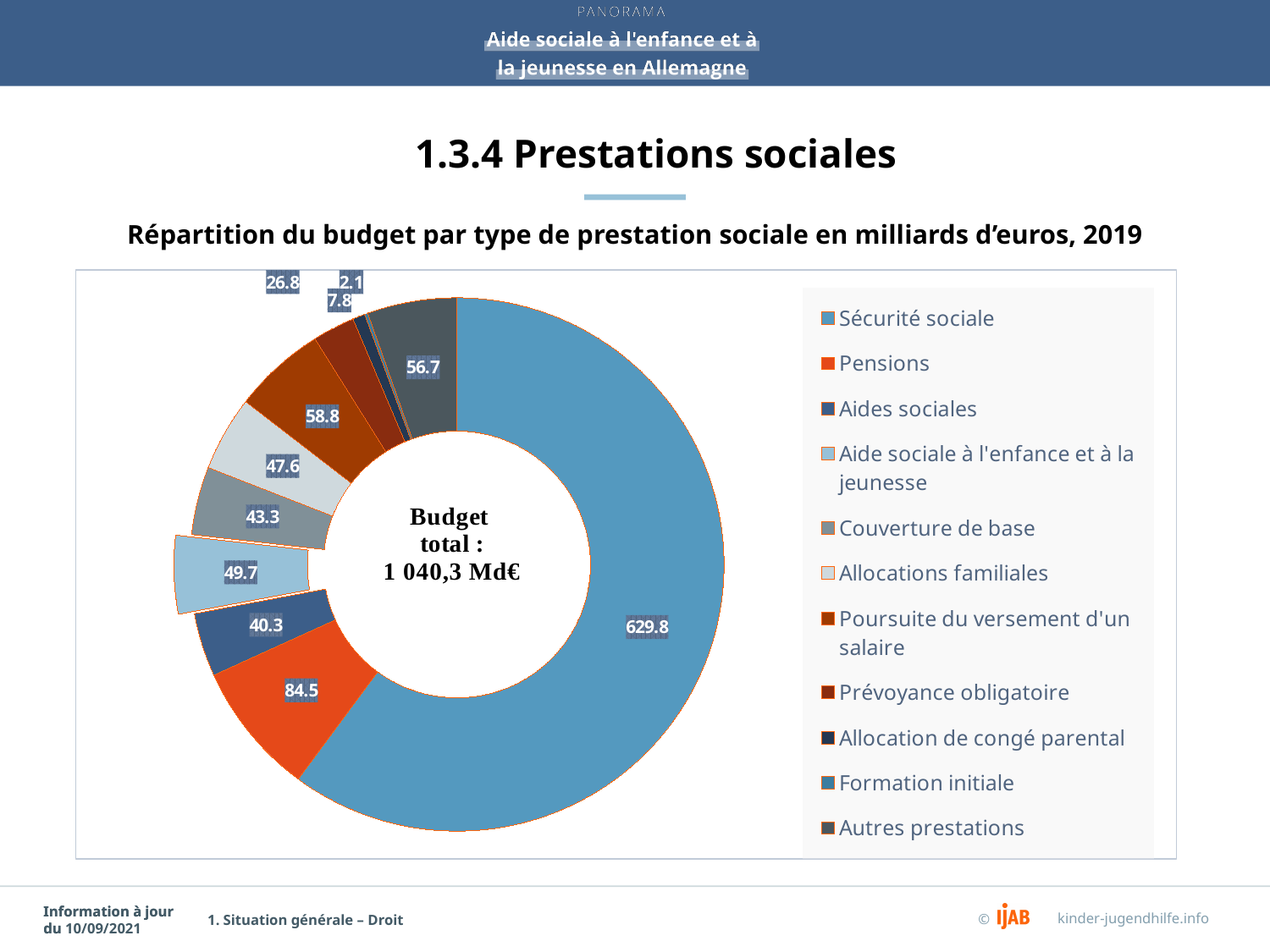
Which category has the largest share of the budget? Sécurité sociale What is the difference between the values for Pensions and Aide sociale à l'enfance et à la jeunesse? 34.8 What is the value for Pensions? 84.5 What is the value for Aide sociale à l'enfance et à la jeunesse? 49.7 Which is larger, Aides sociales or Couverture de base? Couverture de base What is the title of the chart? Répartition du budget par type de prestation sociale en milliards d'euros, 2019 What is the value for Autres prestations? 56.7 What total budget is printed in the centre of the chart? 1 040,3 Md€ How many categories does the legend list? 11 Which category has the smallest value? Formation initiale What is the value for Sécurité sociale? 629.8 What kind of chart is shown on the slide? Pie (doughnut) chart